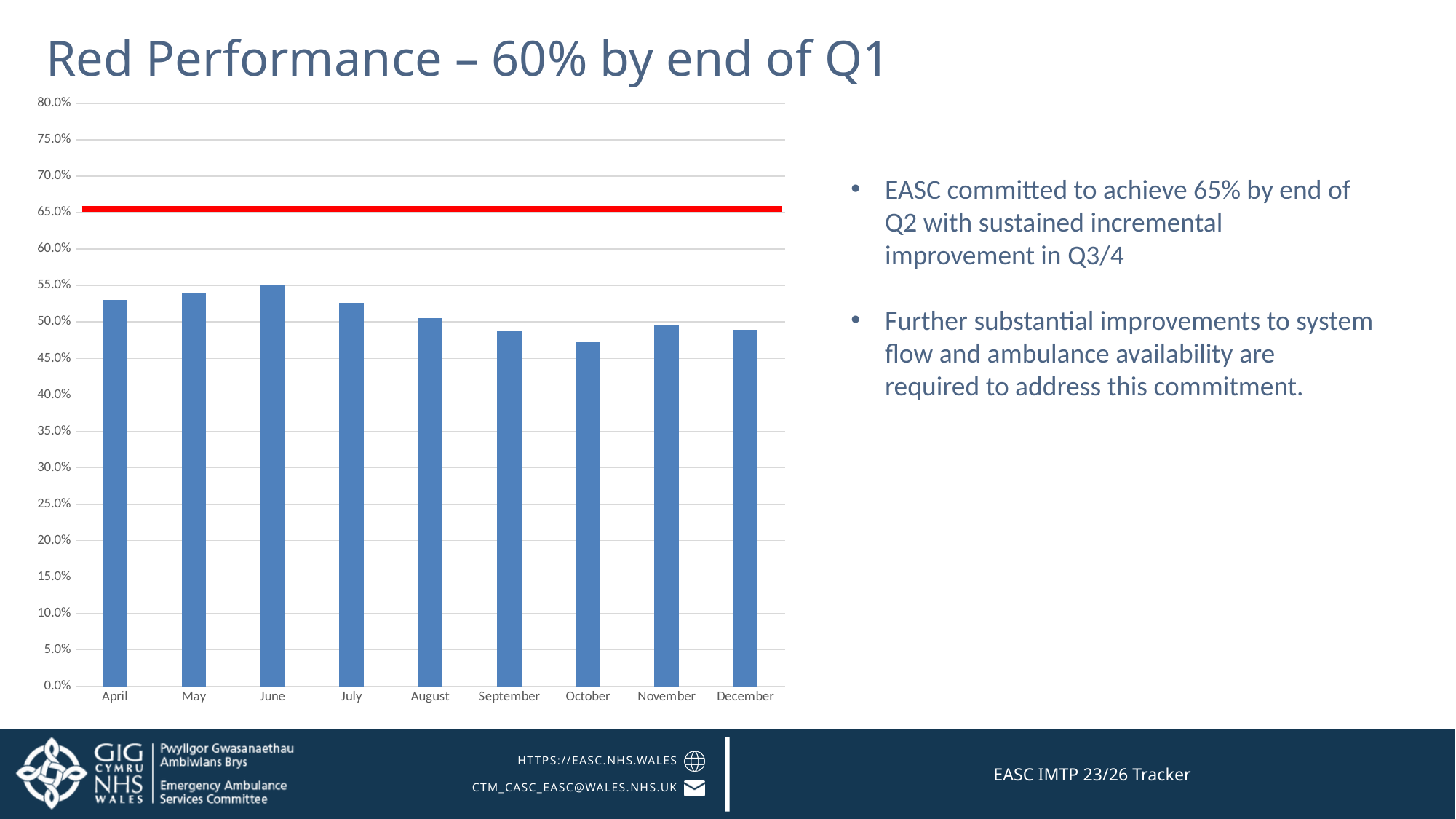
Which month has the highest Red Performance value? June At what level on the y axis is the horizontal red line drawn? 65.0% Is the value for September greater or less than 50.0%? less How many months are plotted on the x axis of the chart? 9 Which month has the lowest Red Performance value? October What kind of chart is shown on the slide? bar chart Do the values rise or fall from June to October? fall Is the value for June greater or less than 60.0%? less Which is larger, the value for April or the value for October? April What is the title of the slide containing the chart? Red Performance – 60% by end of Q1 Is the value for April greater or less than 50.0%? greater